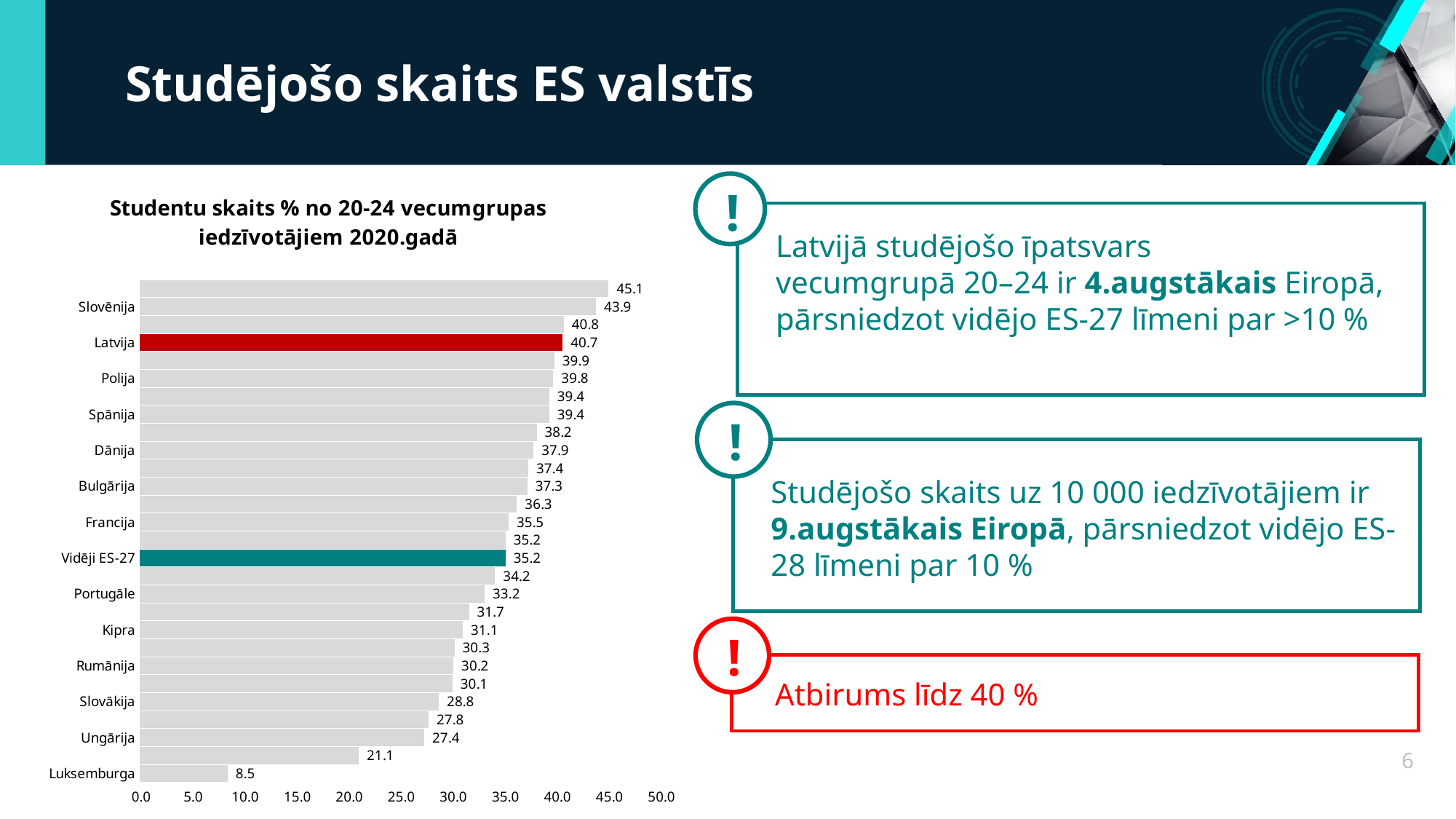
What is the highest value shown in the chart? 45.1 What is the value for Luksemburga? 8.5 What is the difference between the values for Latvija and Vidēji ES-27? 5.5 How many bars are plotted in the chart? 28 What is the value for Latvija in the chart? 40.7 What is the value for Slovēnija? 43.9 Which labelled category has the lowest value? Luksemburga What colour is the bar for Latvija? red Is the value for Kipra greater or less than 30.0? greater What type of chart is shown on the slide? bar chart What is the value for Vidēji ES-27? 35.2 Which has a larger value, Polija or Spānija? Polija